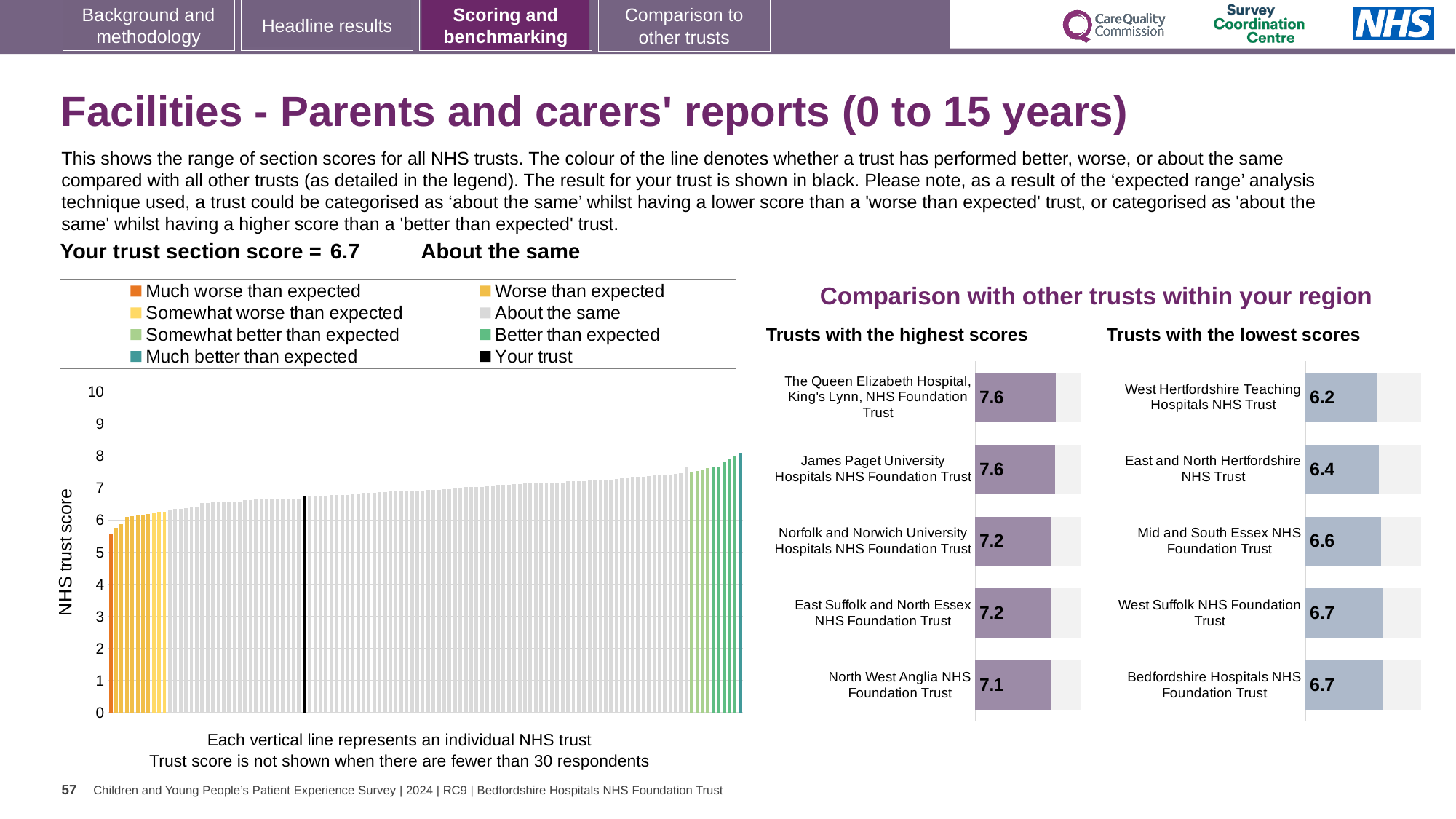
What kind of chart is the large chart on the left with the 'NHS trust score' axis? bar chart In the 'Trusts with the highest scores' chart, what is the difference between the score of The Queen Elizabeth Hospital, King's Lynn, NHS Foundation Trust and North West Anglia NHS Foundation Trust? 0.5 In the large chart on the left, is the value of the lowest (leftmost) bar greater or less than 6? less In the 'Trusts with the lowest scores' chart, which has the larger score: Mid and South Essex NHS Foundation Trust or West Hertfordshire Teaching Hospitals NHS Trust? Mid and South Essex NHS Foundation Trust In the 'Trusts with the highest scores' chart, which trust has the lowest score? North West Anglia NHS Foundation Trust In the 'Trusts with the highest scores' chart, how many trusts are shown? 5 In the large chart on the left, which legend entry is shown in black? Your trust In the 'Trusts with the highest scores' chart, what is the score for North West Anglia NHS Foundation Trust? 7.1 In the 'Trusts with the lowest scores' chart, which trust has the lowest score? West Hertfordshire Teaching Hospitals NHS Trust In the large chart on the left, how many entries does the legend list? 8 In the 'Trusts with the lowest scores' chart, what is the score for East and North Hertfordshire NHS Trust? 6.4 In the large chart on the left, what is the section score for your trust (the black bar)? 6.7